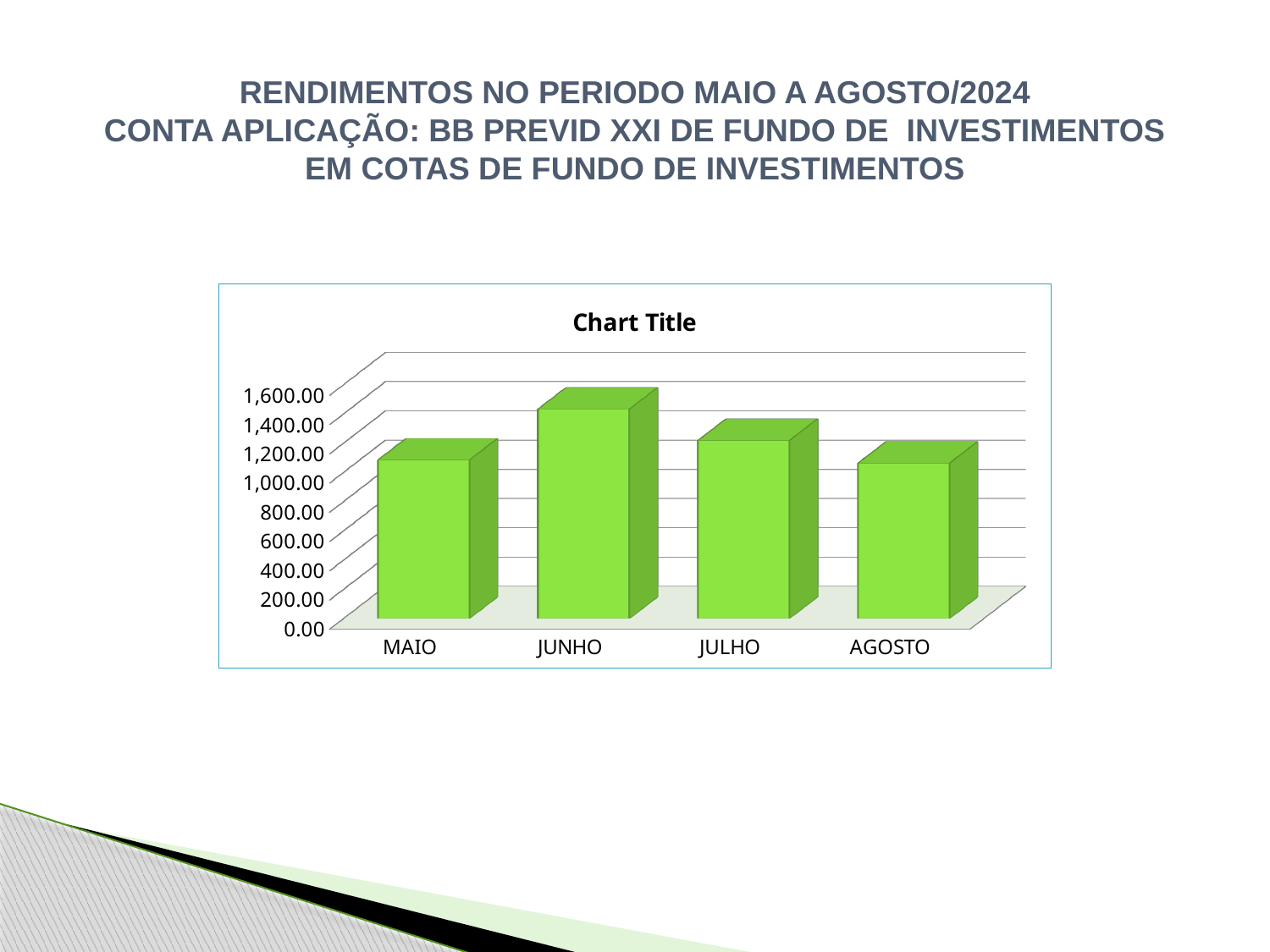
Is the value for AGOSTO greater or less than 1,400.00? less Is the value for MAIO greater or less than 800.00? greater What is the title printed above the chart? Chart Title Is the value for JUNHO greater or less than 1,200.00? greater What colour are the bars in the chart? green Do the values rise or fall from JUNHO to AGOSTO? fall Which month has the highest value in the chart? JUNHO Which is larger, the value for JULHO or the value for AGOSTO? JULHO What kind of chart is shown on the slide? bar chart How many categories are shown on the x axis of the chart? 4 Which is larger, the value for JUNHO or the value for JULHO? JUNHO